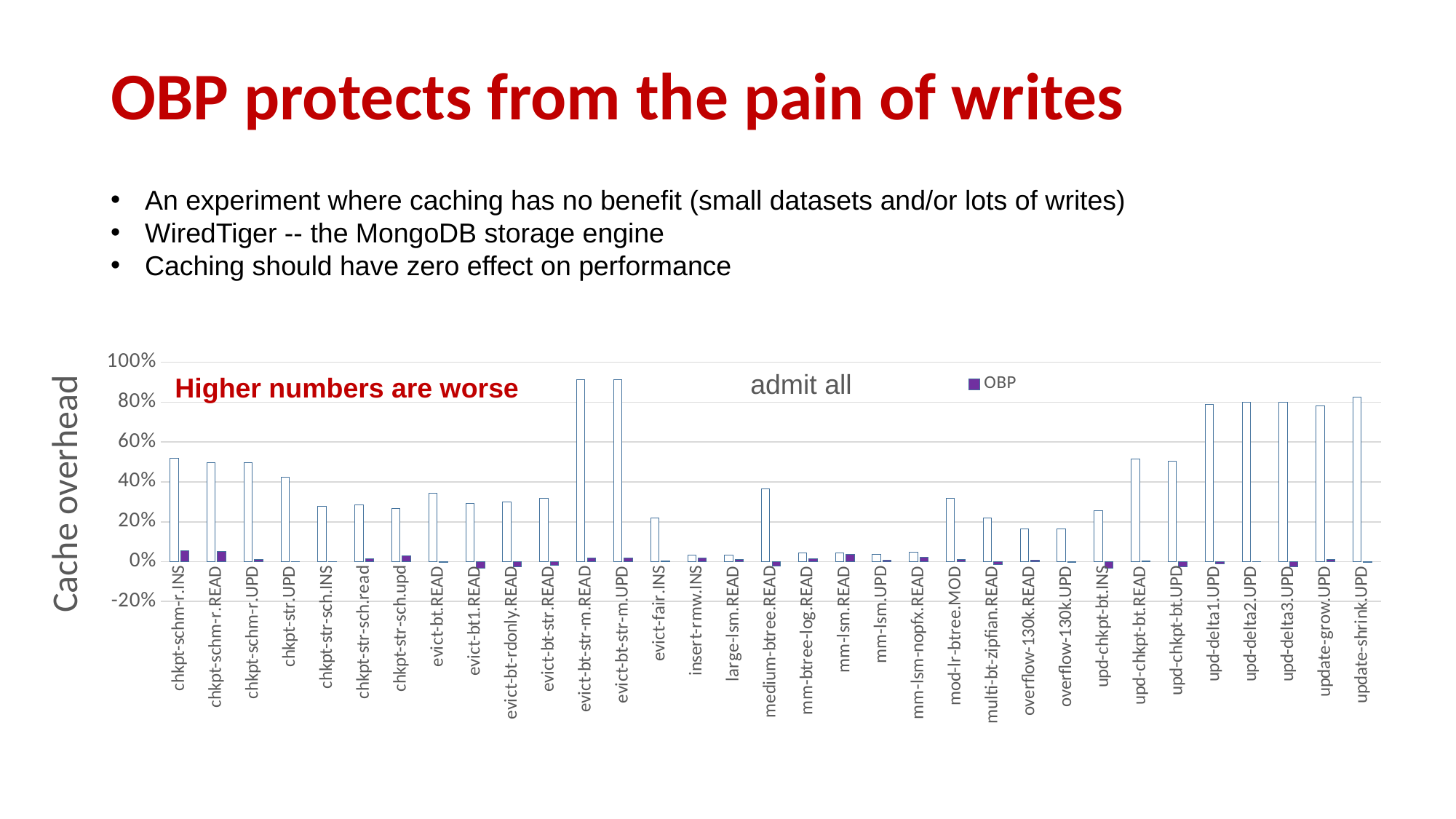
For chkpt-schm-r.INS, which series has the larger value, admit all or OBP? admit all Is the admit all value for chkpt-schm-r.INS greater or less than 40%? greater How many workload categories are plotted along the x axis of the chart? 33 What kind of chart is shown on the slide? bar chart Is the admit all value for evict-bt-str-m.READ greater or less than 80%? greater How many series does the chart's legend list? 2 Is the admit all value for upd-delta1.UPD greater or less than 60%? greater Which has the larger admit all value, evict-bt-str-m.READ or chkpt-str.UPD? evict-bt-str-m.READ What are the two series named in the chart's legend? admit all and OBP What is the label on the chart's vertical axis? Cache overhead